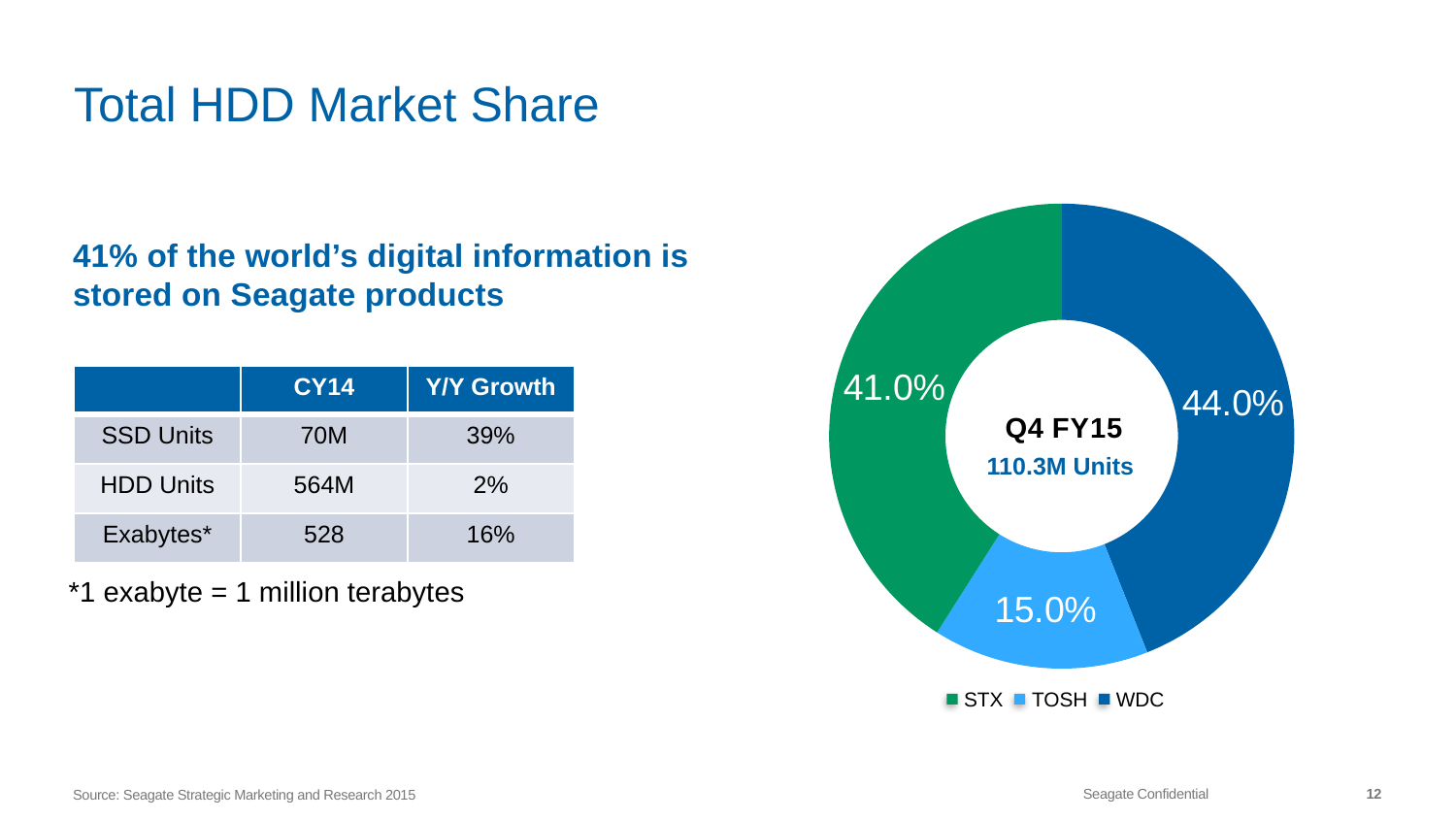
How many companies are shown in the HDD market share chart? 3 What is the difference in market share between STX and TOSH? 26.0% What quarter and total unit count are shown in the center of the chart? Q4 FY15, 110.3M Units What type of chart is used to show the HDD market share? doughnut chart Which company has the largest share in the HDD market share chart? WDC Which company has the smallest share in the HDD market share chart? TOSH What share of the HDD market does STX hold in the chart? 41.0% Which has a larger market share, STX or TOSH? STX What share of the HDD market does WDC hold in the chart? 44.0% What share of the HDD market does TOSH hold in the chart? 15.0% What is the difference in market share between WDC and STX? 3.0% How many entries does the chart legend list? 3